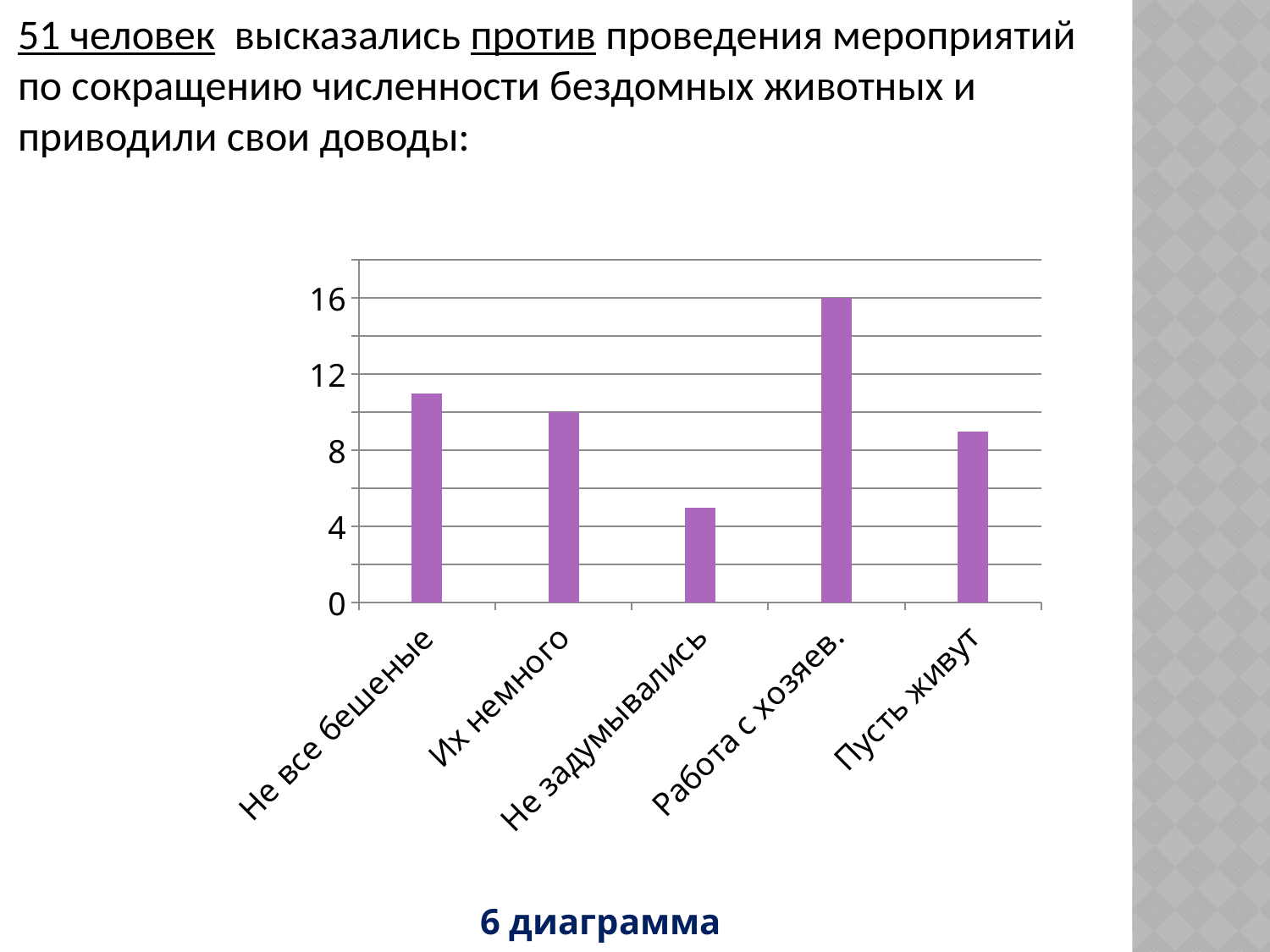
What is the value for "Работа с хозяев." in the chart? 16 Which category has the lowest bar in the chart? Не задумывались What caption is written below the chart? 6 диаграмма Is the value for "Не все бешеные" greater or less than 8? greater Which category has the highest bar in the chart? Работа с хозяев. What kind of chart is shown on the slide? bar chart How many categories are shown on the x axis of the chart? 5 Is the value for "Пусть живут" greater or less than 12? less Which is larger, the value for "Не все бешеные" or the value for "Пусть живут"? Не все бешеные Is the value for "Не задумывались" greater or less than 8? less Which is larger, the value for "Их немного" or the value for "Не задумывались"? Их немного